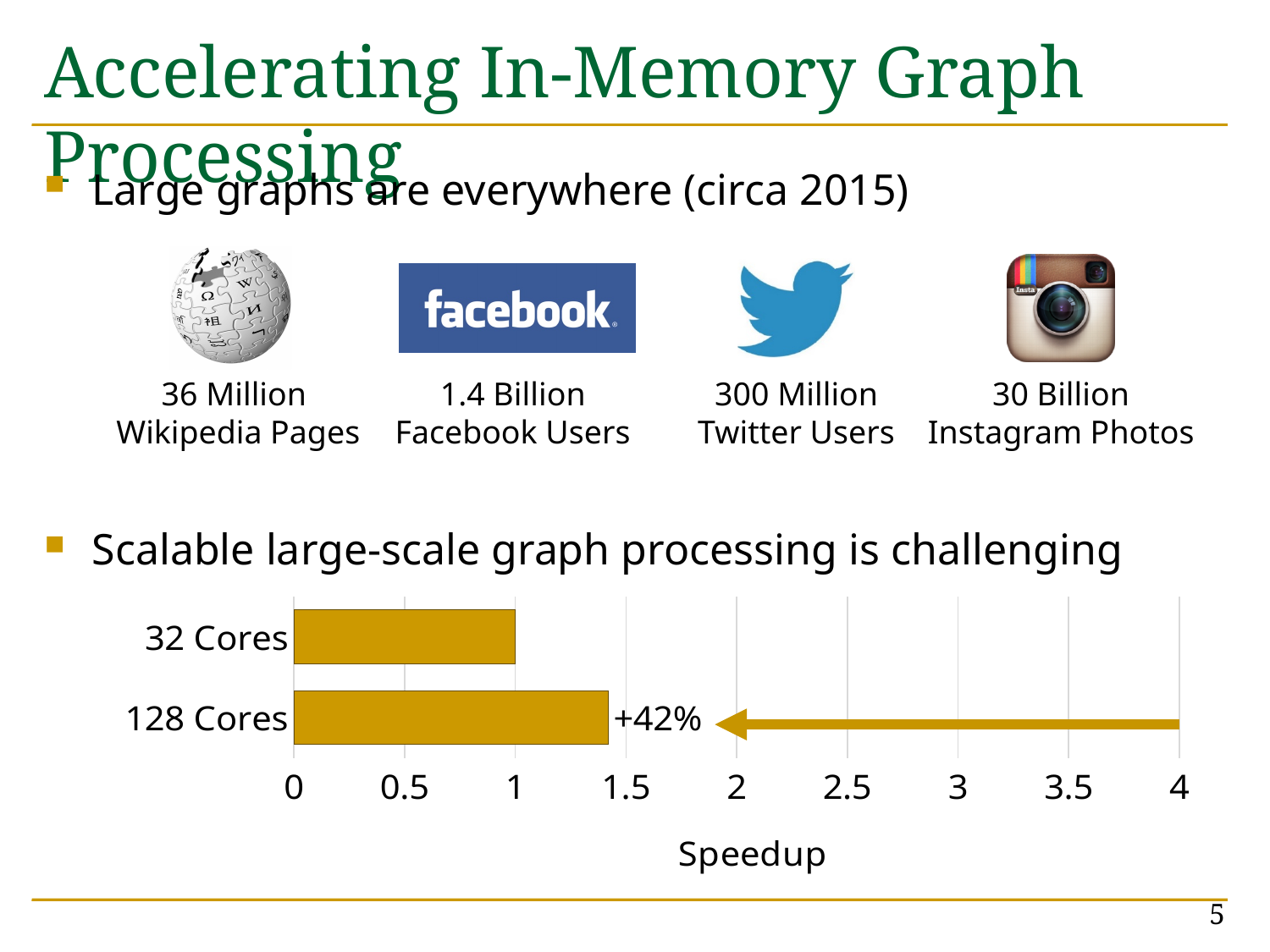
Is the speedup for 128 Cores greater or less than 1? greater Is the speedup for 128 Cores greater or less than 2? less Which category has the lowest speedup in the chart? 32 Cores Which category has the highest speedup in the chart? 128 Cores Which category has the higher speedup, 32 Cores or 128 Cores? 128 Cores What is the title of the x axis of the chart? Speedup What is the maximum value shown on the x axis of the chart? 4 Is the speedup for 128 Cores greater or less than 1.5? less What percentage improvement is annotated next to the 128 Cores bar? +42% How many categories are plotted in the chart? 2 What is the speedup value for 32 Cores? 1 What type of chart is shown on the slide? bar chart